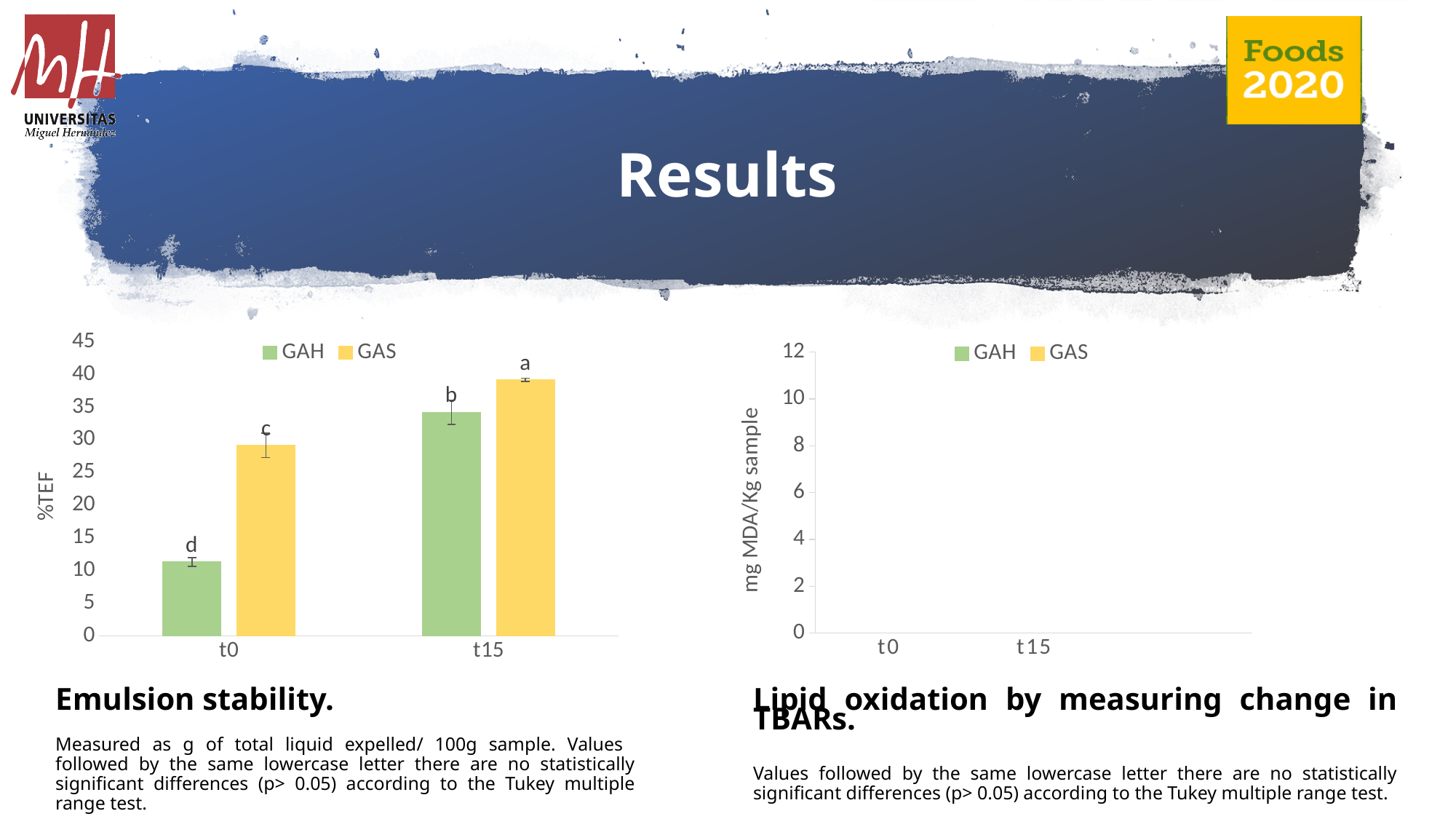
In the Emulsion stability chart on the left, is the value for GAS at t15 greater or less than 35? greater In the Emulsion stability chart on the left, which bar is the highest? GAS at t15 In the Lipid oxidation chart on the right, what is the label on the y axis? mg MDA/Kg sample In the Emulsion stability chart on the left, is the value for GAS at t0 greater or less than 25? greater In the Emulsion stability chart on the left, which bar is the lowest? GAH at t0 In the Emulsion stability chart on the left, how many categories are shown on the x axis? 2 In the Emulsion stability chart on the left, do the GAH values rise or fall from t0 to t15? rise In the Emulsion stability chart on the left, how many series does the legend list? 2 What kind of chart is the Emulsion stability chart on the left? bar chart In the Emulsion stability chart on the left, which is larger at t0, GAH or GAS? GAS In the Emulsion stability chart on the left, is the value for GAH at t15 greater or less than 30? greater